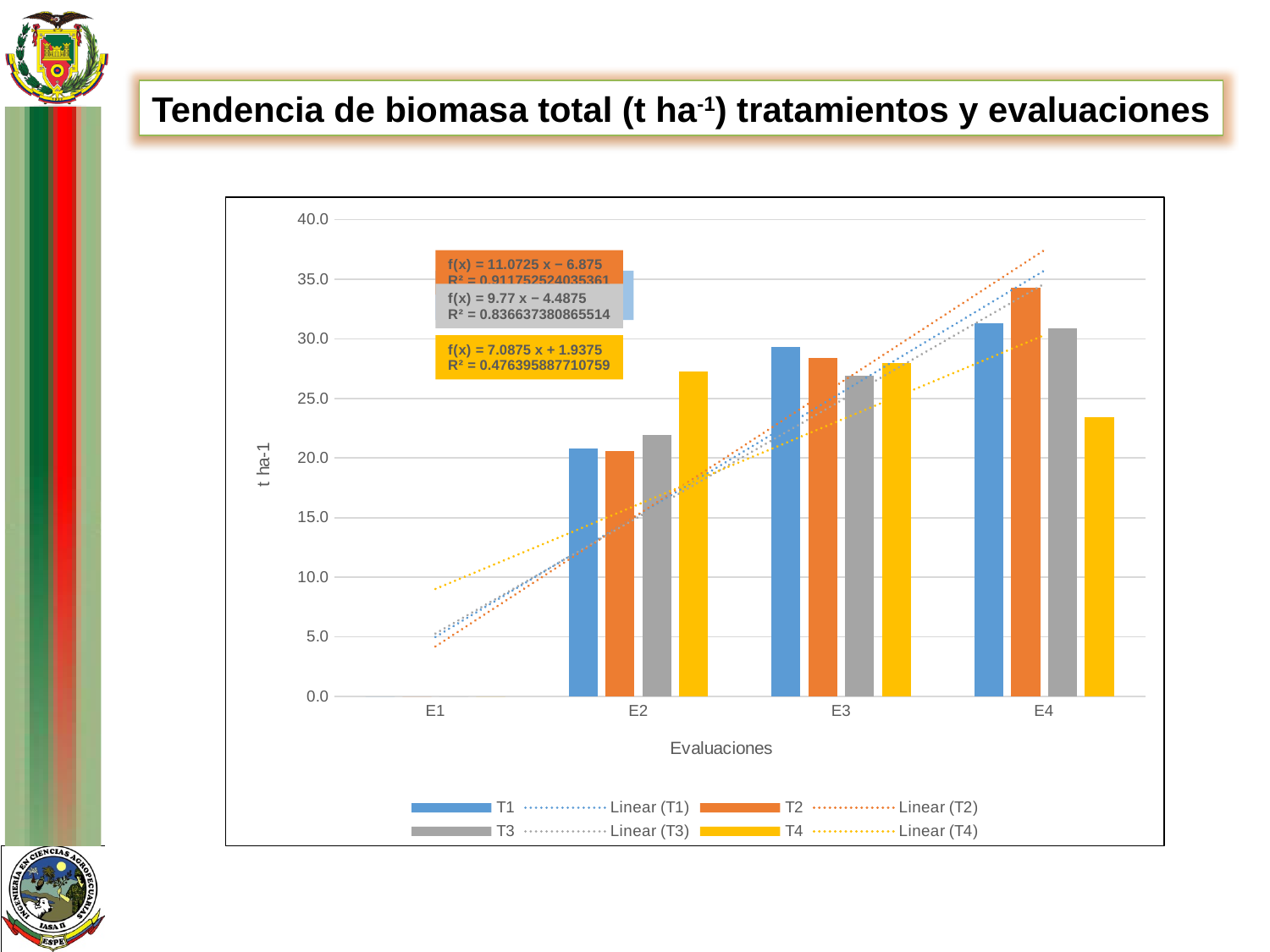
At E2, which is larger, the value for T4 or the value for T1? T4 Is the value for T4 at E4 greater or less than 25.0? less Do the T1 bars rise or fall from E2 to E4? rise Is the value for T1 at E2 greater or less than 25.0? less What kind of chart is shown on the slide? bar chart At E4, which is larger, the value for T2 or the value for T4? T2 Which treatment has the lowest bar at E4? T4 Which treatment has the highest bar at E4? T2 Is the value for T2 at E4 greater or less than 30.0? greater How many entries does the chart legend list? 8 How many categories are labelled on the x axis of the chart? 4